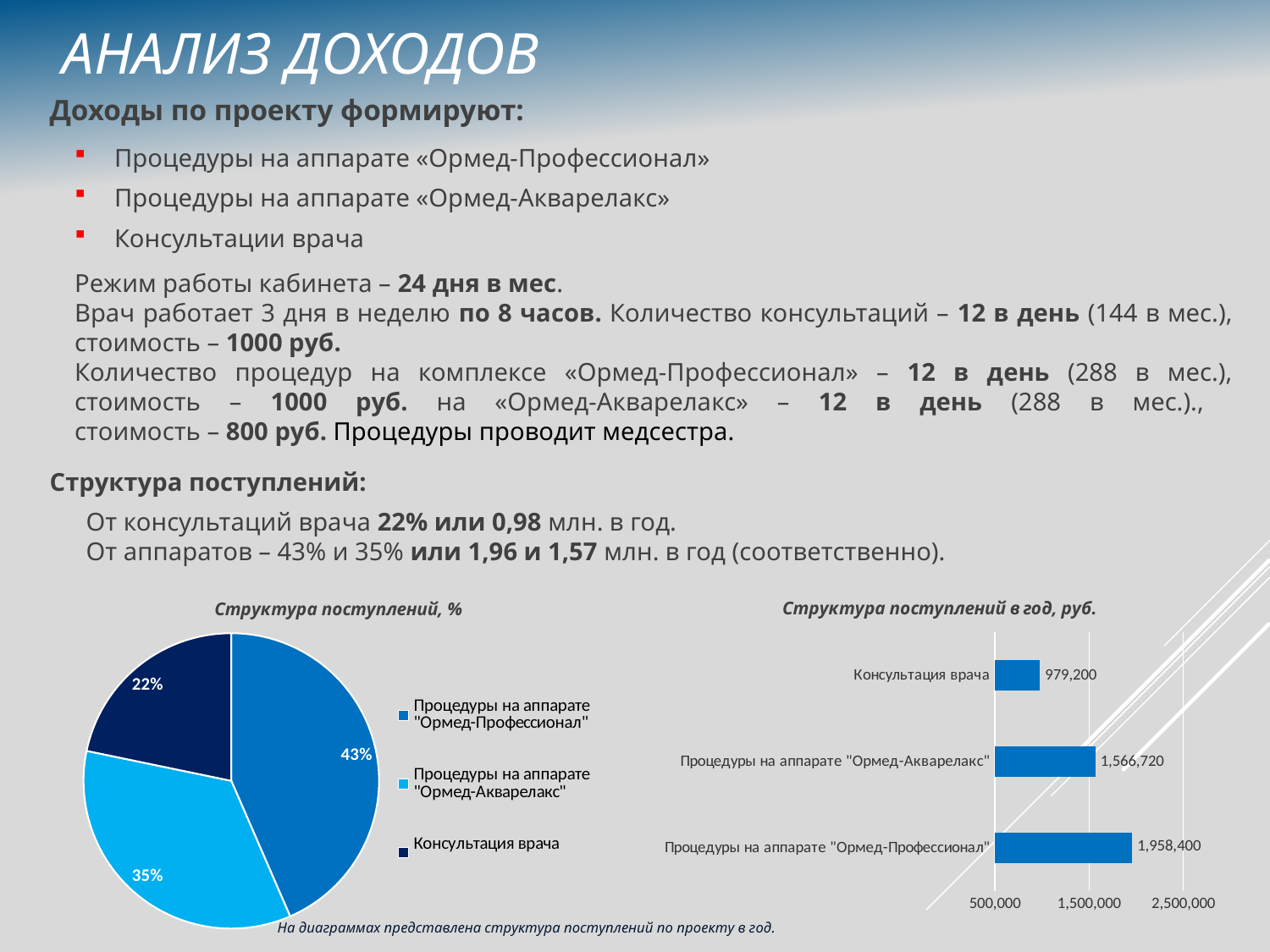
What kind of chart is the one titled "Структура поступлений, %"? Pie chart In the chart titled "Структура поступлений в год, руб.", what is the difference between the values for "Ормед-Профессионал" and "Ормед-Аквареалакс"? 391,680 In the chart titled "Структура поступлений, %", what share does "Консультация врача" have? 22% What kind of chart is the one titled "Структура поступлений в год, руб."? Bar chart In the chart titled "Структура поступлений, %", which category has the smallest slice? Консультация врача In the chart titled "Структура поступлений в год, руб.", which is larger: the value for "Консультация врача" or for "Процедуры на аппарате "Ормед-Аквареалакс""? Процедуры на аппарате "Ормед-Аквареалакс" How many entries does the legend of the chart titled "Структура поступлений, %" list? 3 In the chart titled "Структура поступлений в год, руб.", what is the value for "Процедуры на аппарате "Ормед-Аквареалакс""? 1,566,720 In the chart titled "Структура поступлений в год, руб.", what is the value for "Консультация врача"? 979,200 In the chart titled "Структура поступлений в год, руб.", what is the value for "Процедуры на аппарате "Ормед-Профессионал""? 1,958,400 In the chart titled "Структура поступлений, %", what share does "Процедуры на аппарате "Ормед-Профессионал"" have? 43% In the chart titled "Структура поступлений, %", which category has the largest slice? Процедуры на аппарате "Ормед-Профессионал"